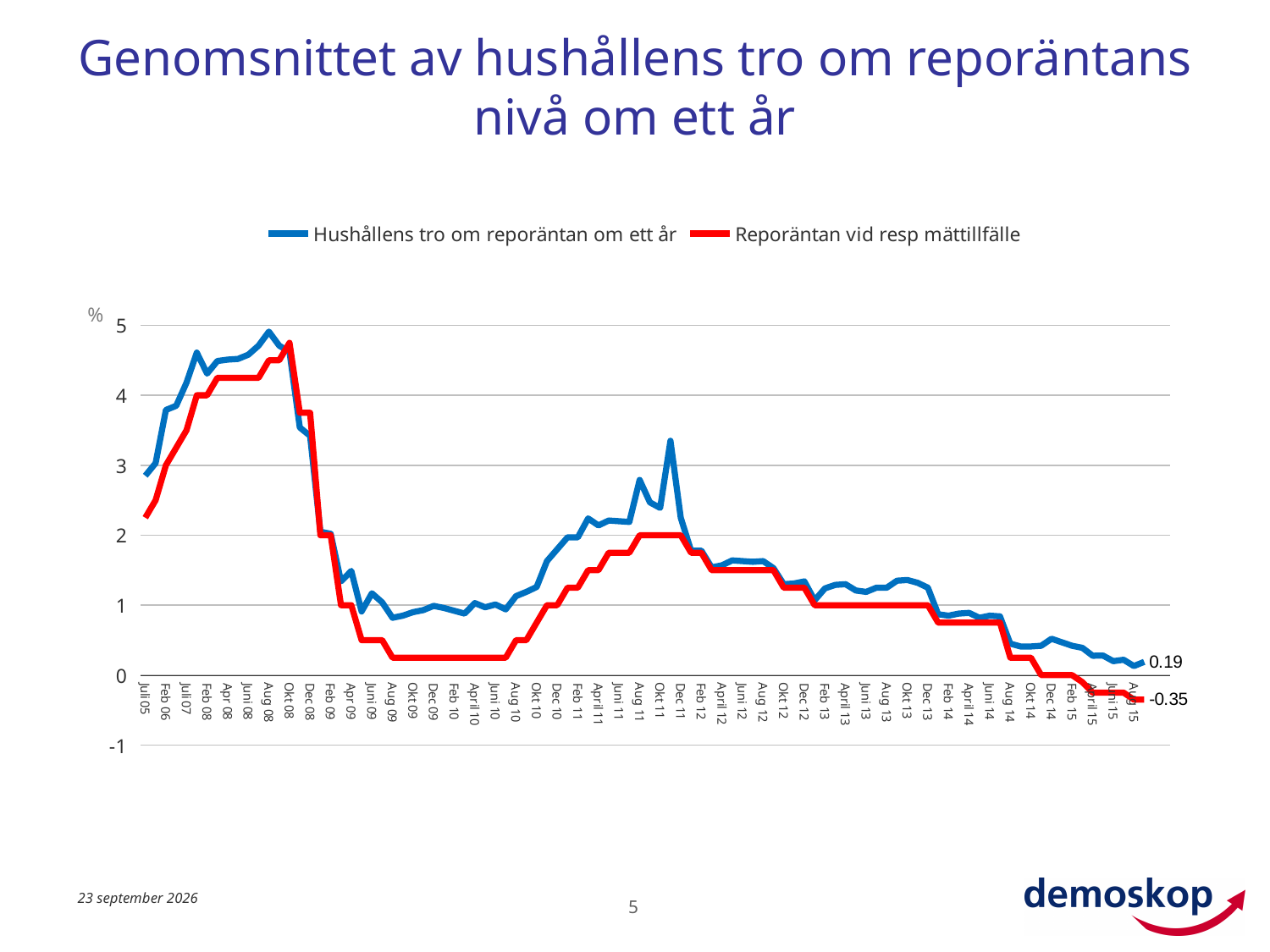
Is the value of 'Reporäntan vid resp mättillfälle' at Aug 09 greater or less than 1? less Is the value of 'Hushållens tro om reporäntan om ett år' at Dec 11 greater or less than 3? less What is the difference between the final labelled values of the two series (0.19 and -0.35)? 0.54 Which colour is used for the series 'Reporäntan vid resp mättillfälle'? Red How many series does the legend list? 2 At the end of the chart, which series has the higher value: 'Hushållens tro om reporäntan om ett år' or 'Reporäntan vid resp mättillfälle'? Hushållens tro om reporäntan om ett år What is the title of the chart on the slide? Genomsnittet av hushållens tro om reporäntans nivå om ett år Is the value of 'Hushållens tro om reporäntan om ett år' at Aug 08 greater or less than 4? greater Between Okt 08 and Aug 09, do the values of 'Reporäntan vid resp mättillfälle' rise or fall? fall What kind of chart is shown on the slide? Line chart What is the last labelled value of the series 'Reporäntan vid resp mättillfälle'? -0.35 What is the last labelled value of the series 'Hushållens tro om reporäntan om ett år'? 0.19